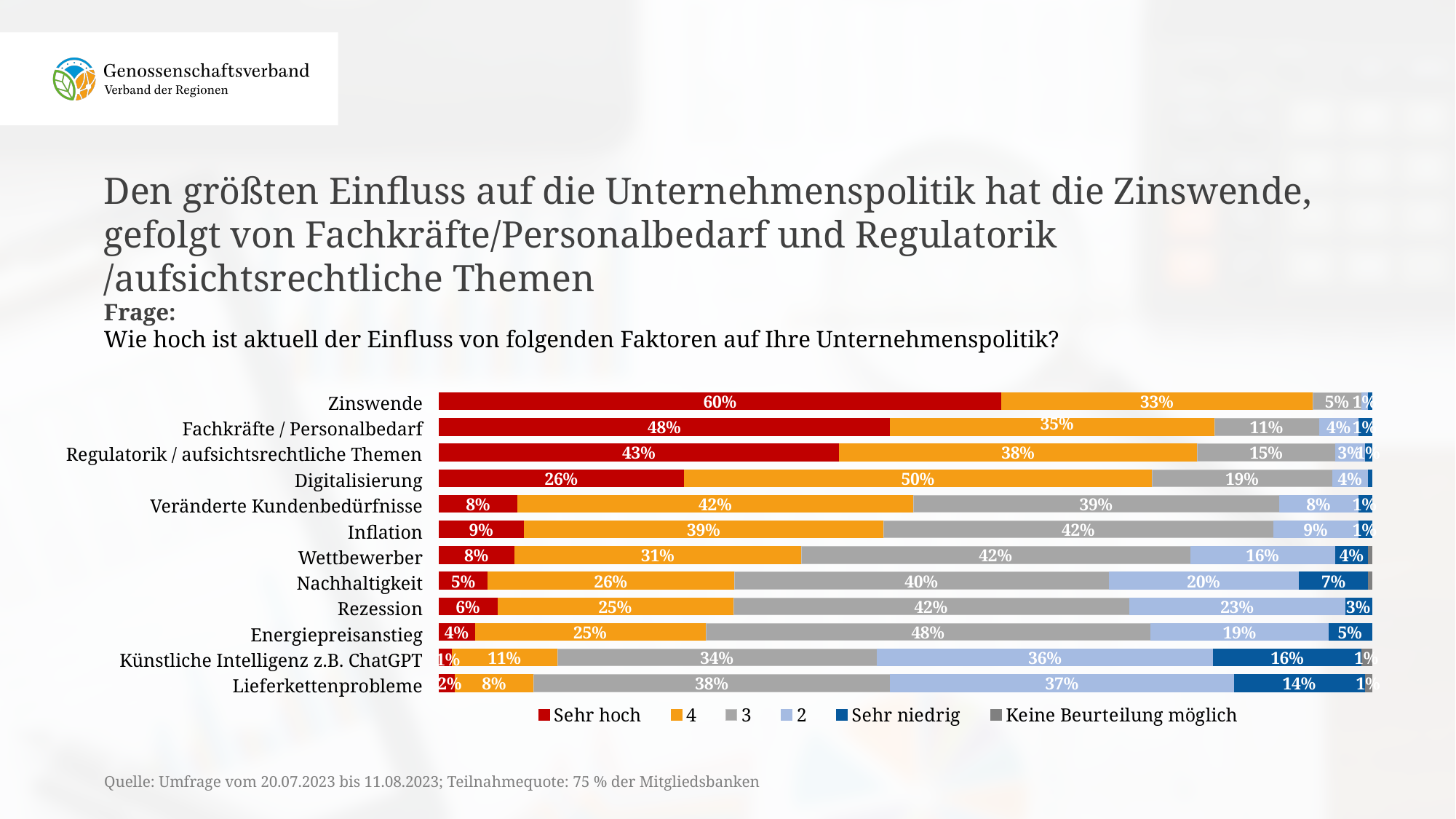
What is the "3" rating share for Energiepreisanstieg? 48% What is the difference between the "Sehr hoch" shares of Zinswende and Fachkräfte / Personalbedarf? 12% What share of respondents gave Lieferkettenprobleme a "Sehr niedrig" rating? 14% How many factors are listed in the chart? 12 What percentage of respondents rated the influence of Zinswende as "Sehr hoch"? 60% Which factor has the lowest "Sehr hoch" share? Künstliche Intelligenz z.B. ChatGPT What is the "4" rating share for Digitalisierung? 50% How many series does the legend list? 6 What kind of chart is shown on the slide? Stacked bar chart Which factor has the highest "Sehr hoch" share? Zinswende Which has a larger "2" rating share: Rezession or Nachhaltigkeit? Rezession Which colour represents the "Sehr hoch" rating in the chart? Red